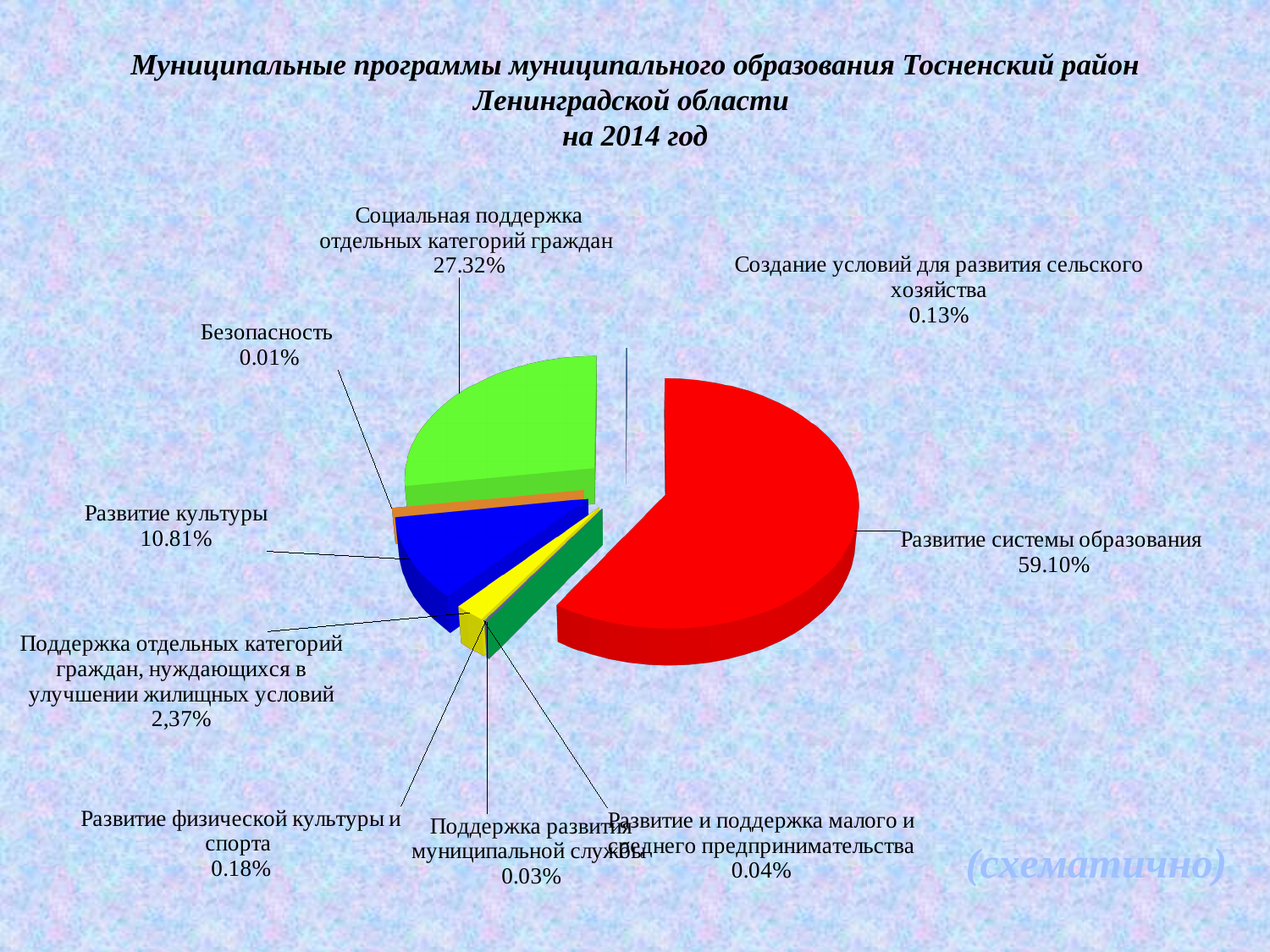
What colour is the slice for Развитие системы образования? red What percentage is shown for Развитие культуры? 10.81% What is the difference between the shares of Развитие системы образования and Социальная поддержка отдельных категорий граждан? 31.78% What share does Развитие системы образования have in the pie chart? 59.10% Which is larger: the share for Развитие культуры or the share for Развитие физической культуры и спорта? Развитие культуры Which category has the smallest share of the pie? Безопасность How many categories are shown in the pie chart? 9 What is the value shown for Социальная поддержка отдельных категорий граждан? 27.32% What value is labelled for Безопасность? 0.01% Which category has the largest share of the pie? Развитие системы образования What kind of chart is shown on the slide? pie chart What is the value for Поддержка отдельных категорий граждан, нуждающихся в улучшении жилищных условий? 2,37%